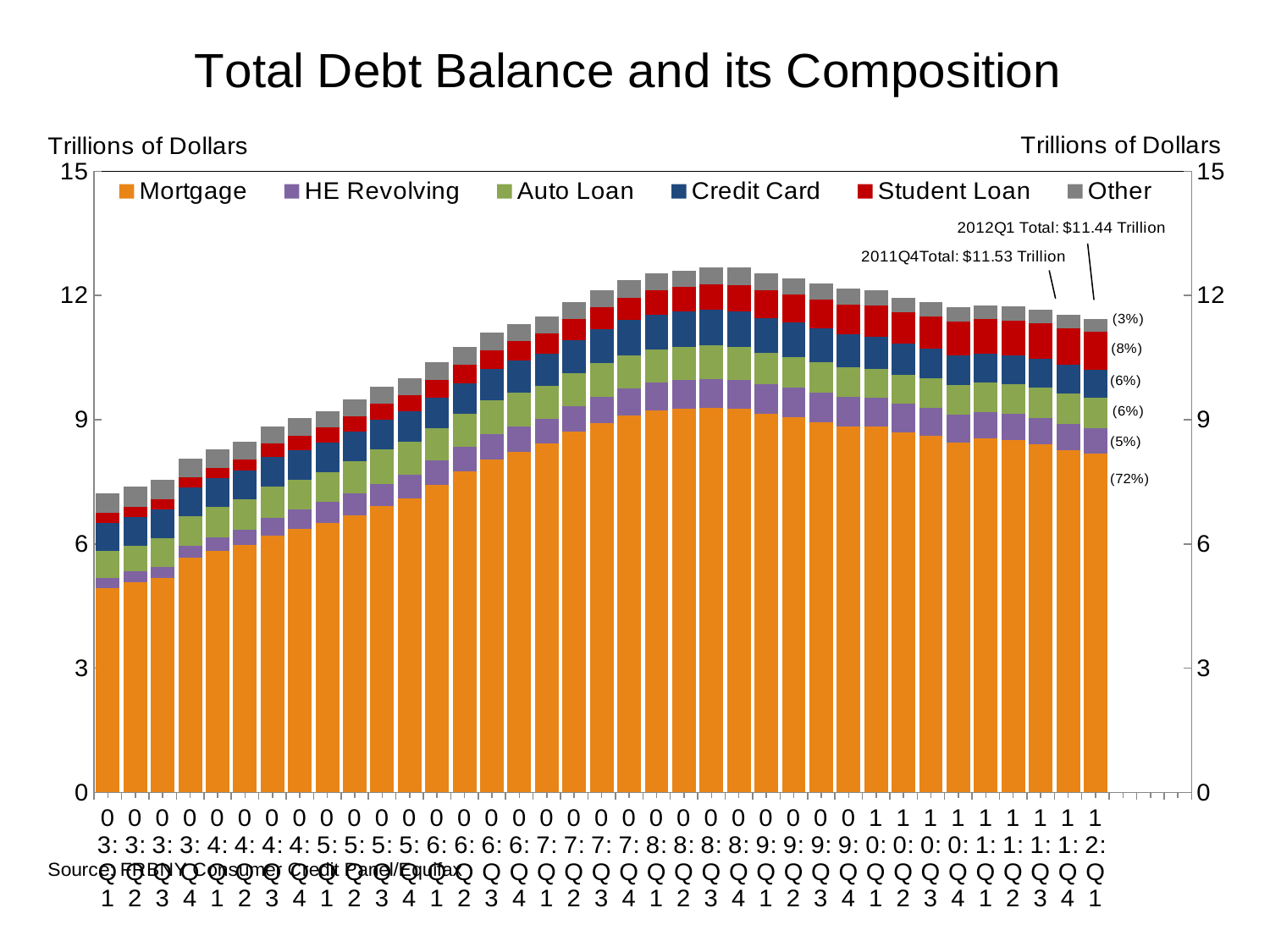
What kind of chart is shown on the slide? Stacked bar chart What is the total debt balance for 2011Q4 according to the annotation? $11.53 Trillion Which quarter has the larger total debt balance, 2011Q4 or 2012Q1? 2011Q4 Which series forms the bottom segment of each stacked bar? Mortgage What share of the 2012Q1 total is Mortgage debt? 72% How many series does the legend list? 6 What is the total debt balance for 2012Q1 according to the annotation? $11.44 Trillion Do total debt balances rise or fall from 03:Q1 to 08:Q3? rise What share of the 2012Q1 total is Student Loan debt? 8% How many quarterly bars are plotted in the chart? 37 Is the total debt balance for 03:Q1 greater or less than 9 trillion dollars? less By how much did the total debt balance change from 2011Q4 to 2012Q1? $0.09 Trillion